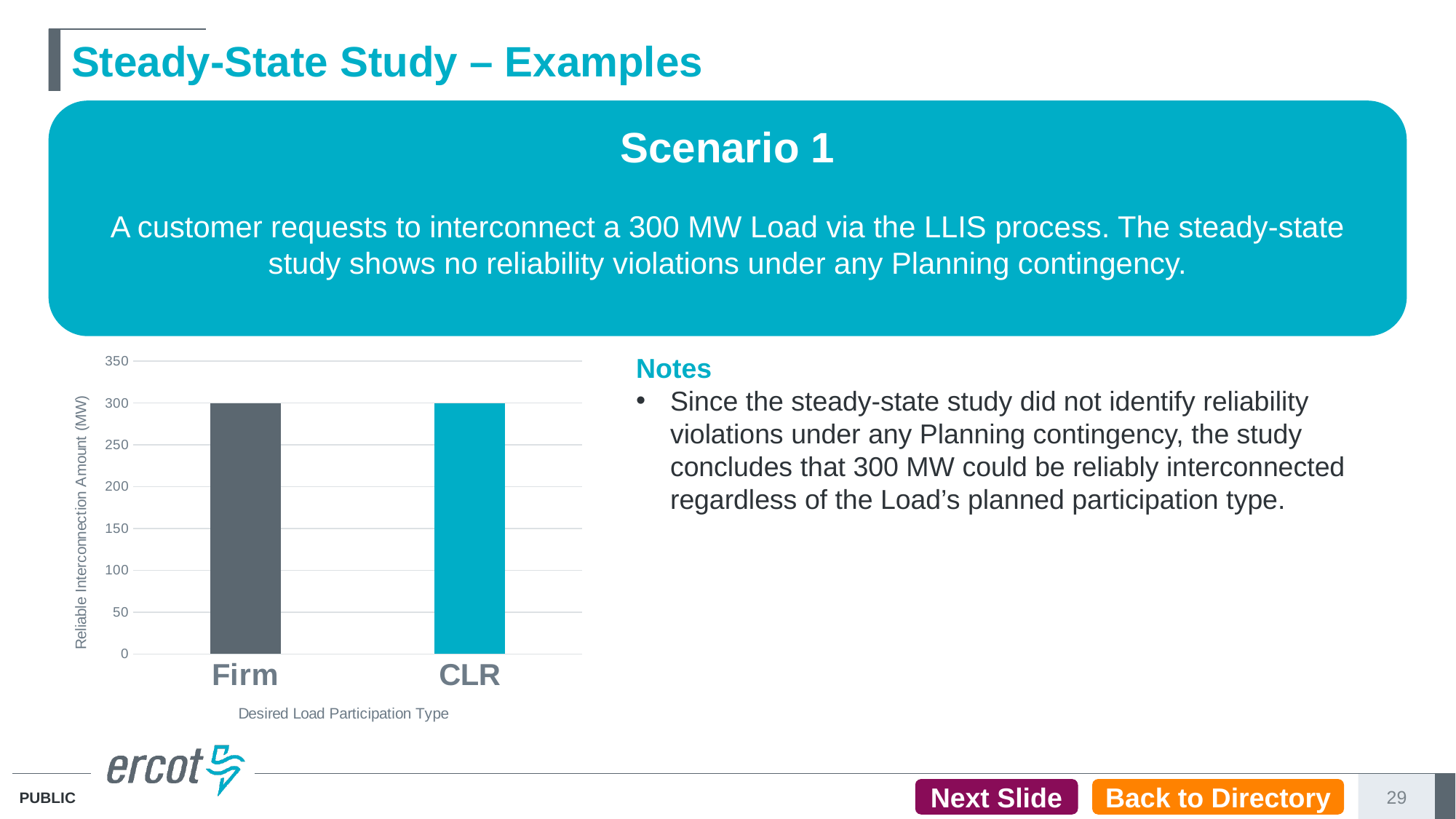
Is the value for Firm greater or less than 250? greater How many categories are shown on the x axis of the chart? 2 What is the Reliable Interconnection Amount (MW) for Firm? 300 What is the label of the x axis? Desired Load Participation Type What is the label of the y axis? Reliable Interconnection Amount (MW) What is the difference between the values for Firm and CLR? 0 Do the values change between Firm and CLR along the x axis? No, they stay the same What type of chart is shown on the slide? Bar chart What is the highest value shown on the y axis? 350 What is the Reliable Interconnection Amount (MW) for CLR? 300 Is the value for CLR greater or less than 350? less